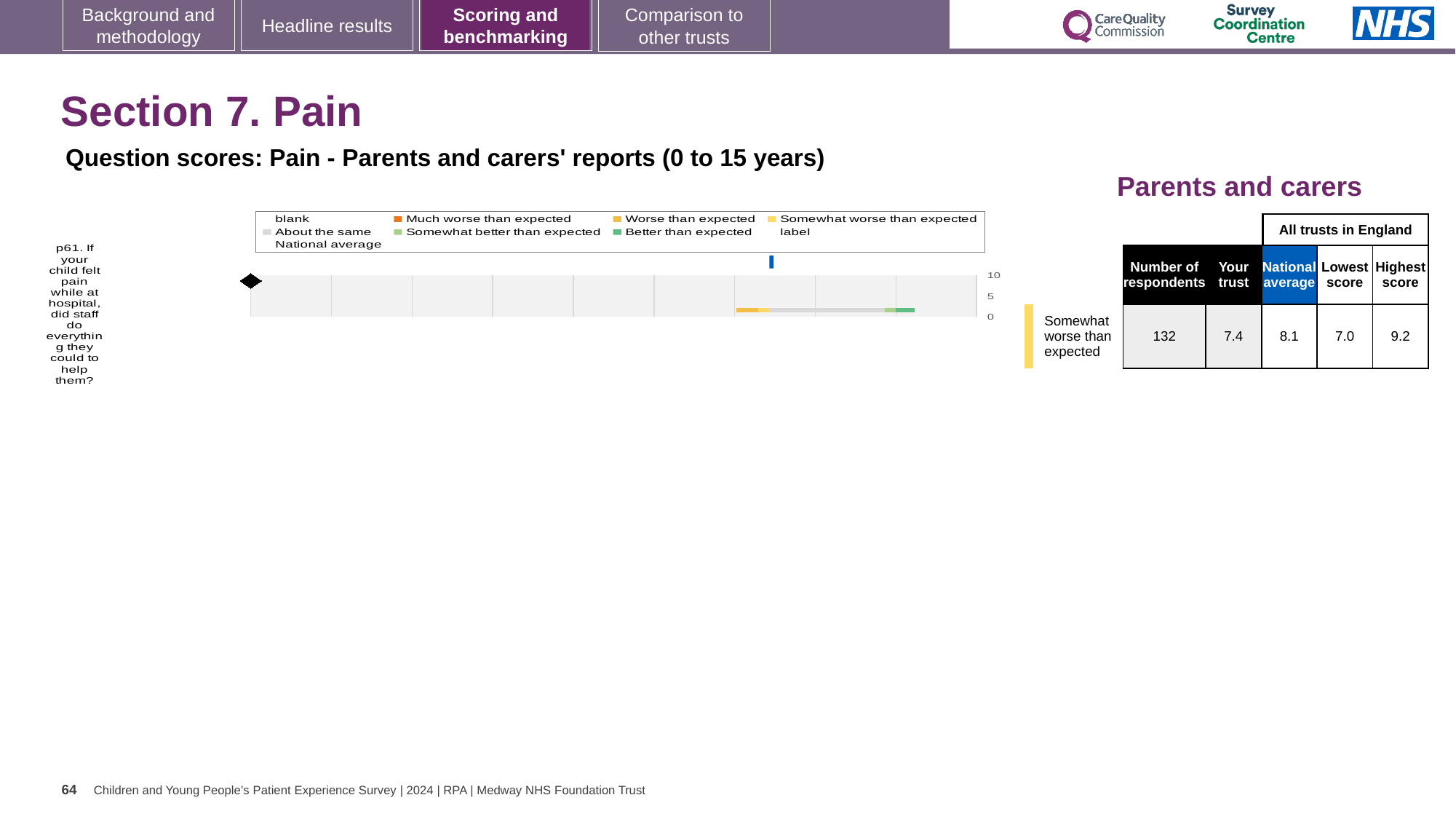
How many respondents answered the pain question, according to the table? 132 What is the question number of the item plotted in the chart? p61 What kind of chart is shown on the slide? bar chart How many survey questions are plotted in the chart? 1 What is the difference between the National average (8.1) and the 'Your trust' score (7.4) for the pain question? 0.7 In the table, what is the Highest score among all trusts in England for the pain question? 9.2 Which is larger for the pain question: the 'Your trust' score or the National average? National average What is the highest tick value shown on the chart's score axis? 10 In the table, what is the 'Your trust' score for the question 'If your child felt pain while at hospital, did staff do everything they could to help them?' 7.4 Which benchmark category is the trust's score for the pain question assigned to? Somewhat worse than expected In the table, what is the National average score for the pain question? 8.1 In the table, what is the Lowest score among all trusts in England for the pain question? 7.0